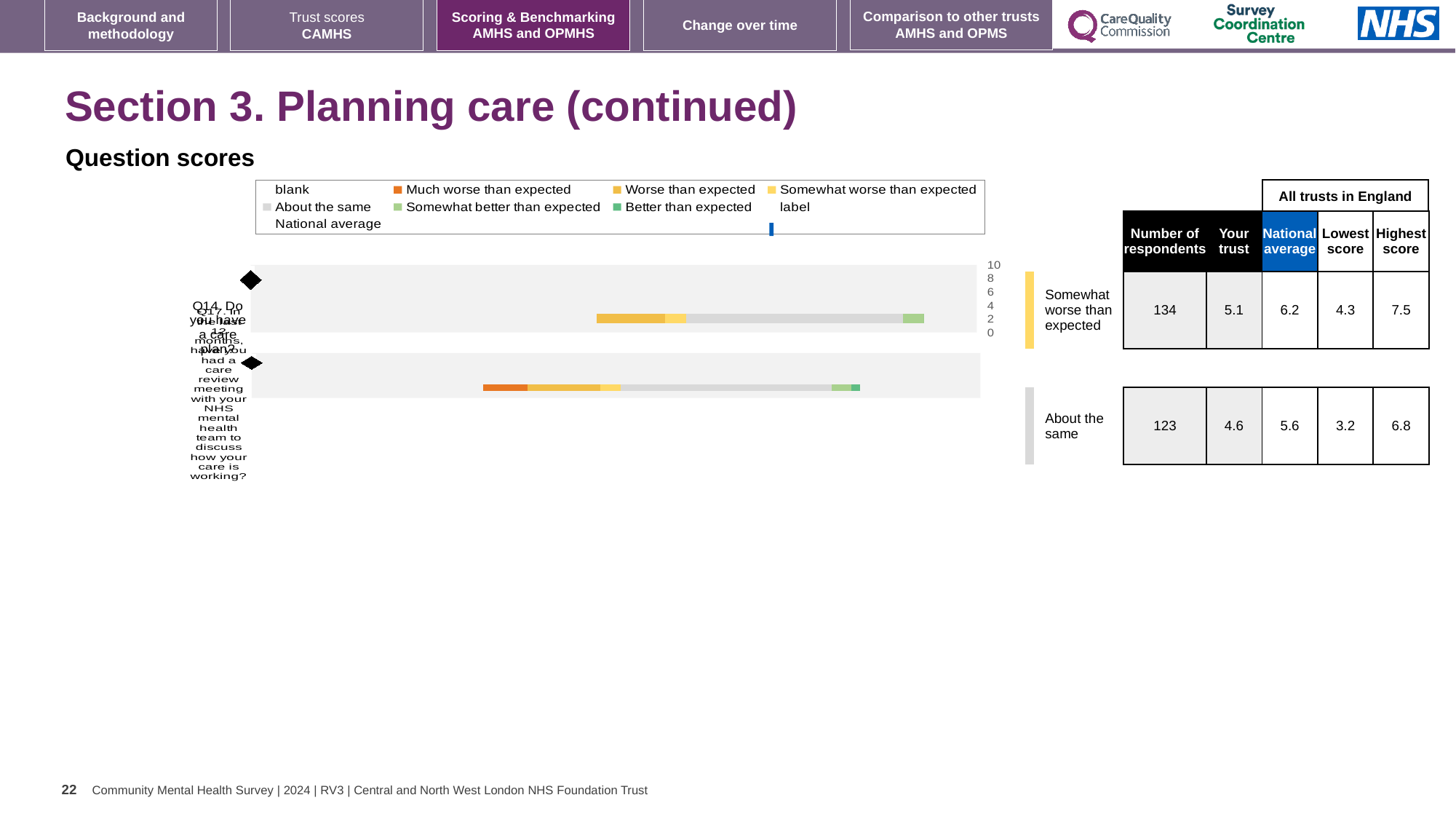
In the chart legend, what colour represents 'Better than expected'? green According to the table beside the chart, what is the 'Your trust' score for Q14 (Do you have a care plan?)? 5.1 According to the table beside the chart, what is the national average for Q17? 5.6 How many questions (rows) are plotted in the question scores chart? 2 According to the table beside the chart, how many respondents answered Q17? 123 What kind of chart is shown under 'Question scores'? bar chart According to the table beside the chart, what is the 'Your trust' score for Q17 (care review meeting)? 4.6 According to the table beside the chart, how many respondents answered Q14? 134 Which question has the higher 'Your trust' score in the table beside the chart, Q14 or Q17? Q14 According to the table beside the chart, what is the national average for Q14? 6.2 In the chart legend, what colour represents 'Much worse than expected'? orange What is the difference between the national average and the 'Your trust' score for Q14 in the table beside the chart? 1.1